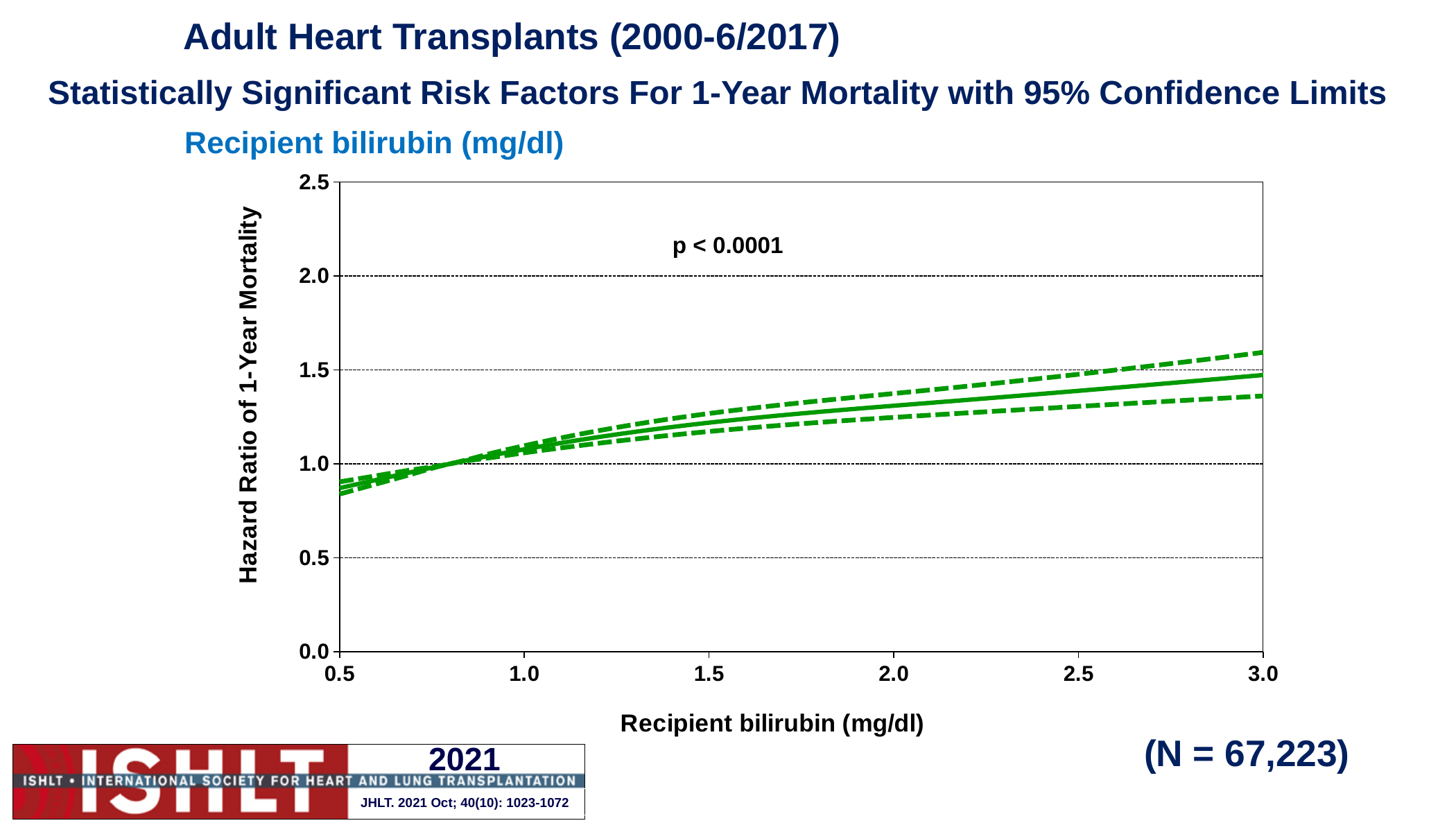
Which recipient bilirubin level has the higher hazard ratio, 1.0 mg/dl or 2.5 mg/dl? 2.5 mg/dl How many lines (solid and dashed) are plotted on the chart? 3 Is the hazard ratio for a recipient bilirubin of 2.0 mg/dl greater or less than 1.5? less Is the hazard ratio for a recipient bilirubin of 0.5 mg/dl greater or less than 1.0? less Is the hazard ratio for a recipient bilirubin of 3.0 mg/dl greater or less than 2.0? less What is the lowest recipient bilirubin value shown on the x-axis? 0.5 Does the hazard ratio of 1-year mortality rise or fall as recipient bilirubin increases from 0.5 to 3.0 mg/dl? rise What p-value is printed on the chart? p < 0.0001 What is the label of the y-axis? Hazard Ratio of 1-Year Mortality What kind of chart is shown on the slide? line chart What is the highest value shown on the y-axis? 2.5